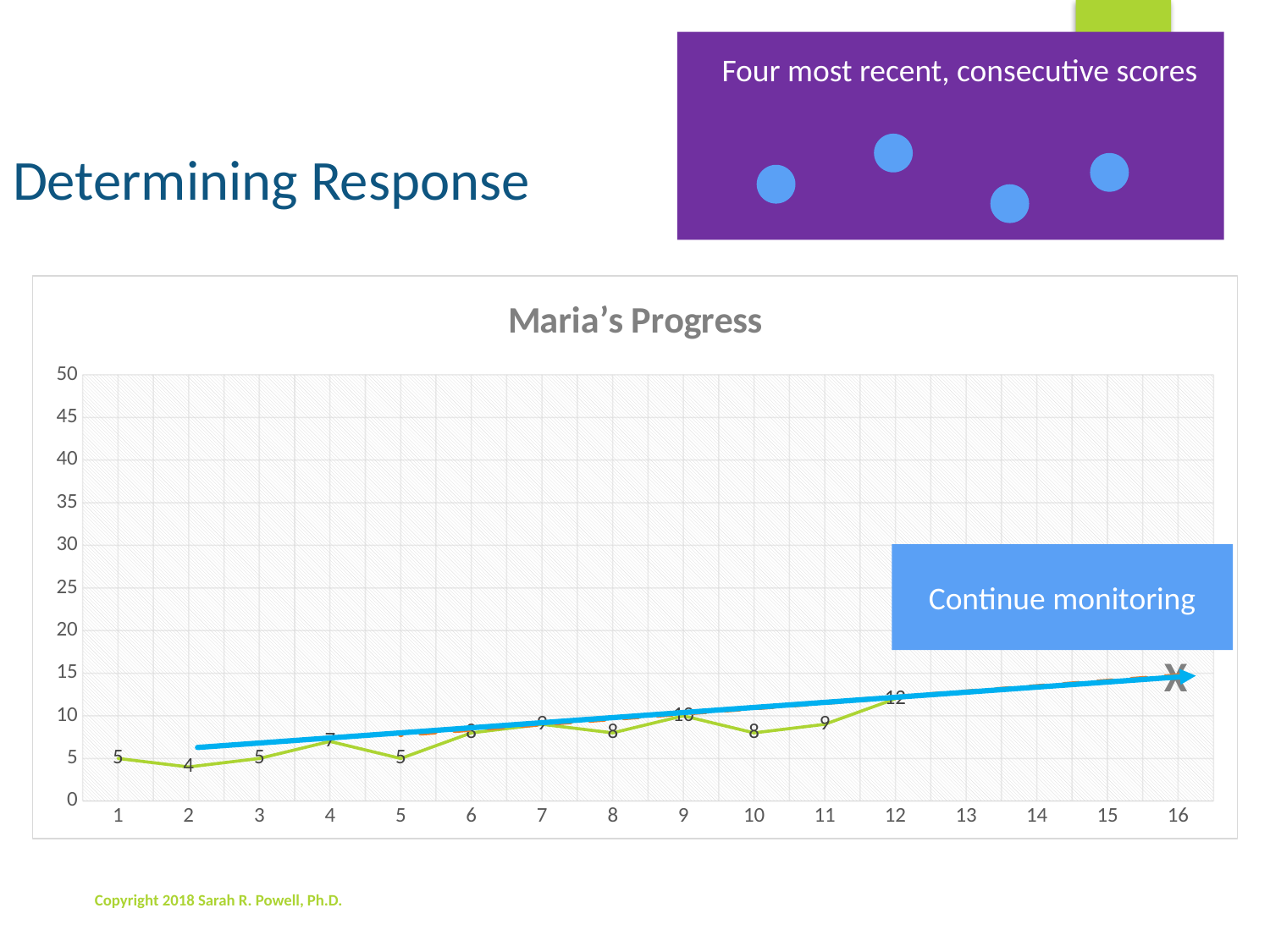
What is the difference between Maria's score at point 12 and her score at point 1? 7 What is Maria's score at point 1? 5 What is Maria's score at point 6? 8 What kind of chart is shown on the slide? line chart How many data points are plotted on the line? 12 What is the title of the chart? Maria's Progress At which point is Maria's score highest? 12 What is Maria's score at point 2? 4 At which point is Maria's score lowest? 2 Do Maria's scores generally rise or fall from point 1 to point 12? rise Which is larger, Maria's score at point 4 or at point 5? point 4 What is Maria's score at point 12? 12